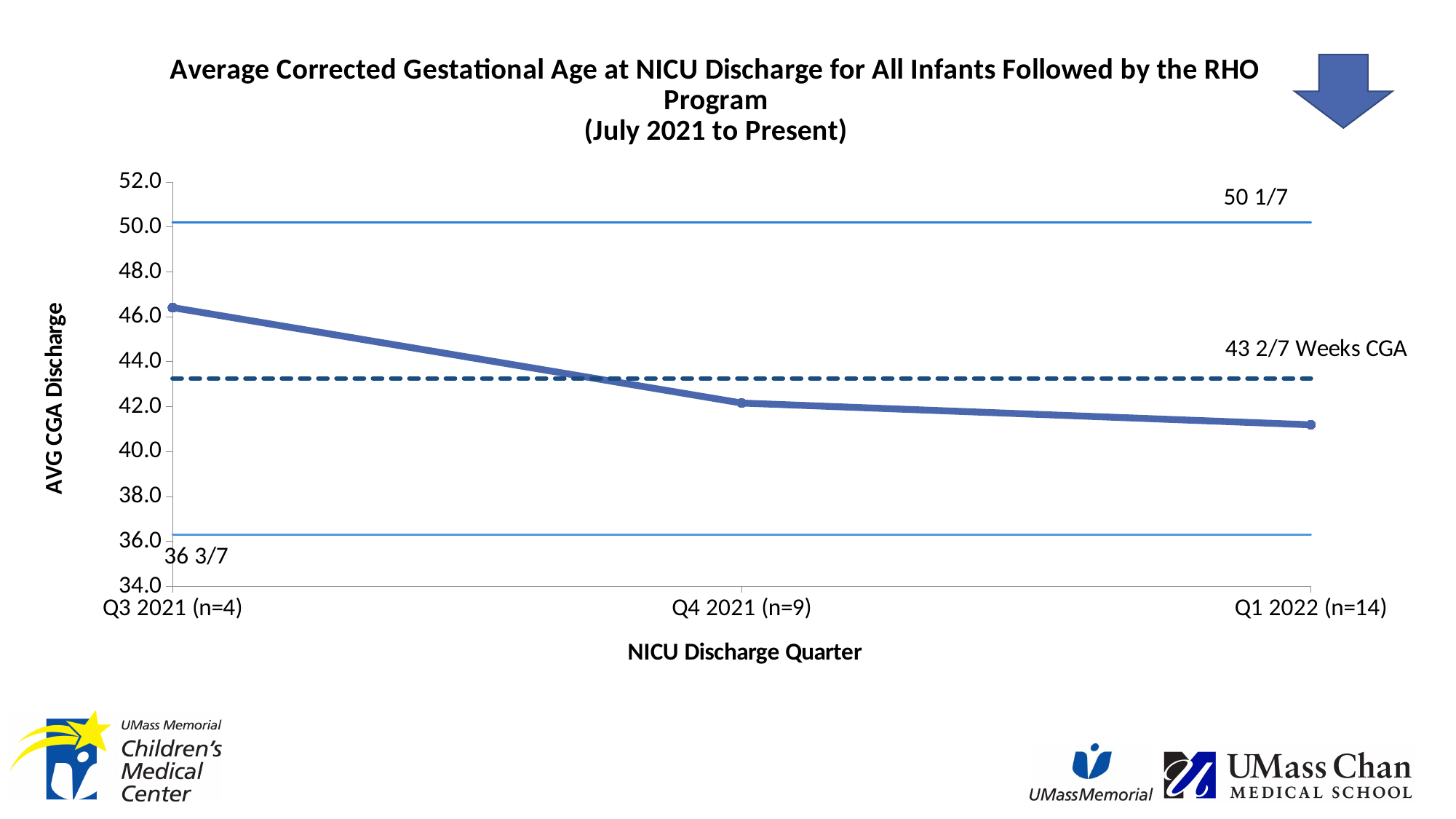
Which is larger, the value for Q3 2021 (n=4) or the value for Q4 2021 (n=9)? Q3 2021 (n=4) Does the average CGA at discharge rise or fall from Q3 2021 to Q1 2022? fall Which quarter has the highest average CGA at discharge? Q3 2021 (n=4) Is the value for Q4 2021 (n=9) greater or less than 44.0? less Is the value for Q4 2021 (n=9) greater or less than 40.0? greater How many NICU discharge quarters are plotted on the x axis? 3 Is the value for Q3 2021 (n=4) greater or less than 44.0? greater Which quarter has the lowest average CGA at discharge? Q1 2022 (n=14) What kind of chart is shown on the slide? line chart What label is shown next to the dashed horizontal reference line? 43 2/7 Weeks CGA What is the label of the y axis? AVG CGA Discharge